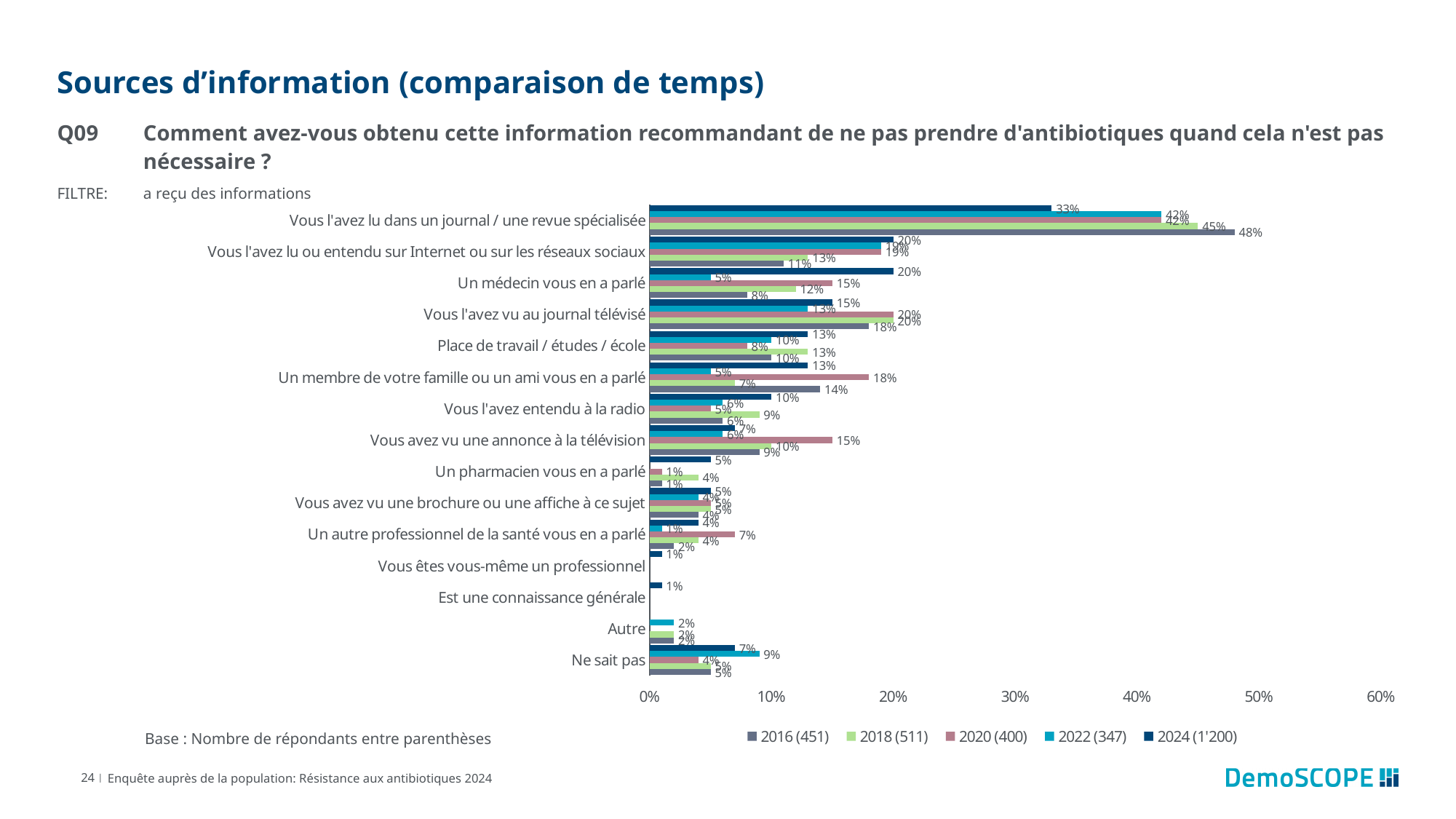
Is the 2020 (400) value for "Vous avez vu une annonce à la télévision" greater or less than 10%? greater For "Un médecin vous en a parlé", which is larger: the 2024 (1'200) value or the 2022 (347) value? 2024 (1'200) How many categories are shown on the y axis of the chart? 15 What is the 2024 (1'200) value for "Vous l'avez lu dans un journal / une revue spécialisée"? 33% What is the 2022 (347) value for "Ne sait pas"? 9% Which category has the highest 2024 (1'200) value? Vous l'avez lu dans un journal / une revue spécialisée What is the 2016 (451) value for "Vous l'avez lu dans un journal / une revue spécialisée"? 48% How many series does the legend list? 5 What is the 2020 (400) value for "Un membre de votre famille ou un ami vous en a parlé"? 18% What is the difference between the 2016 (451) and 2024 (1'200) values for "Vous l'avez lu dans un journal / une revue spécialisée"? 15% What kind of chart is shown on the slide? bar chart What is the 2020 (400) value for "Un autre professionnel de la santé vous en a parlé"? 7%